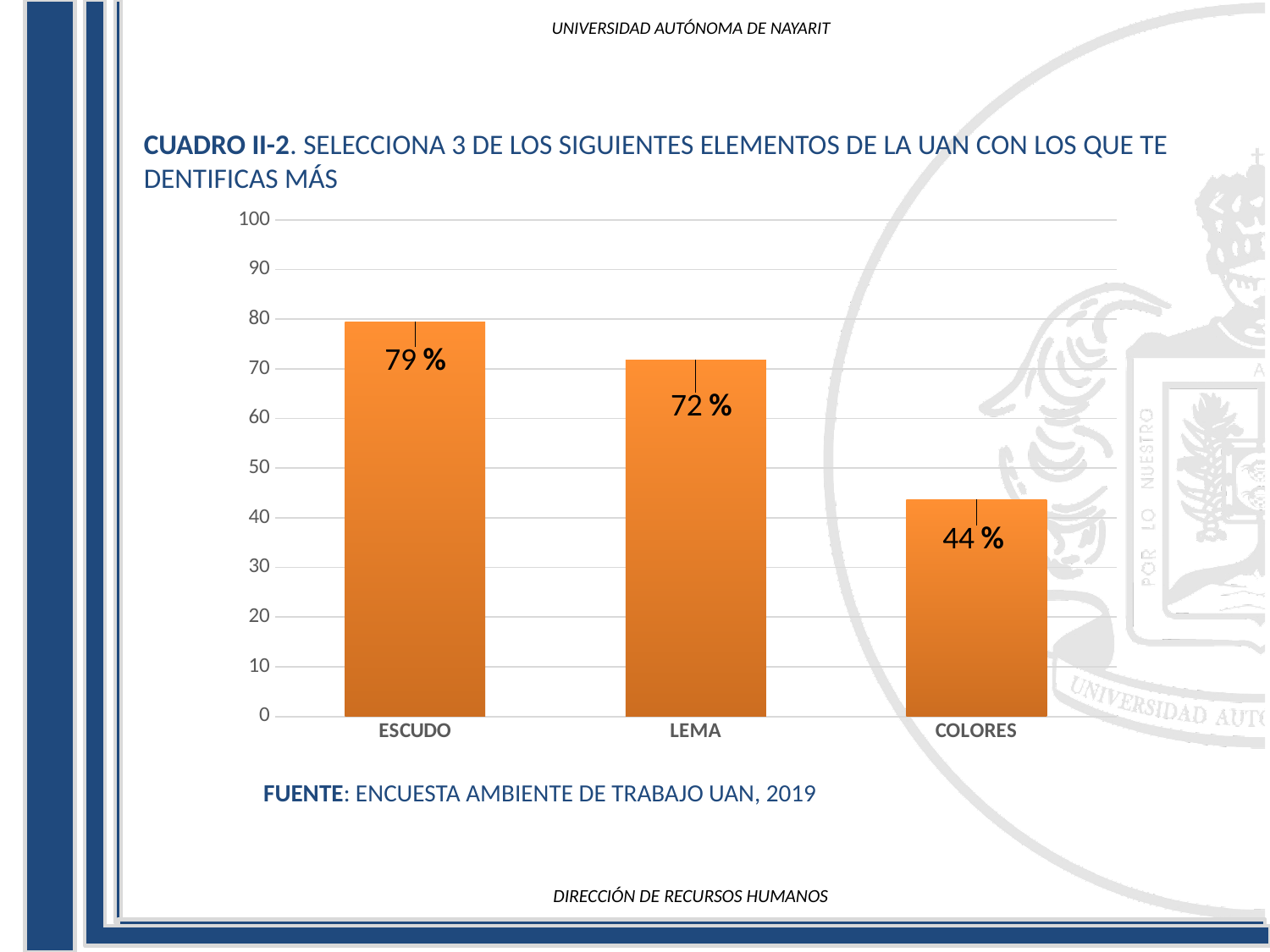
What is the value for COLORES? 44 % What is the difference between the values for ESCUDO and LEMA? 7 % How many categories are shown in the chart? 3 What is the value for ESCUDO? 79 % Which category has the lowest value? COLORES What is the value for LEMA? 72 % Is the value for COLORES greater or less than 50? less Which category has the highest value? ESCUDO Which is larger, the value for LEMA or the value for COLORES? LEMA What kind of chart is shown on the slide? bar chart What source is cited below the chart? ENCUESTA AMBIENTE DE TRABAJO UAN, 2019 What is the difference between the values for ESCUDO and COLORES? 35 %